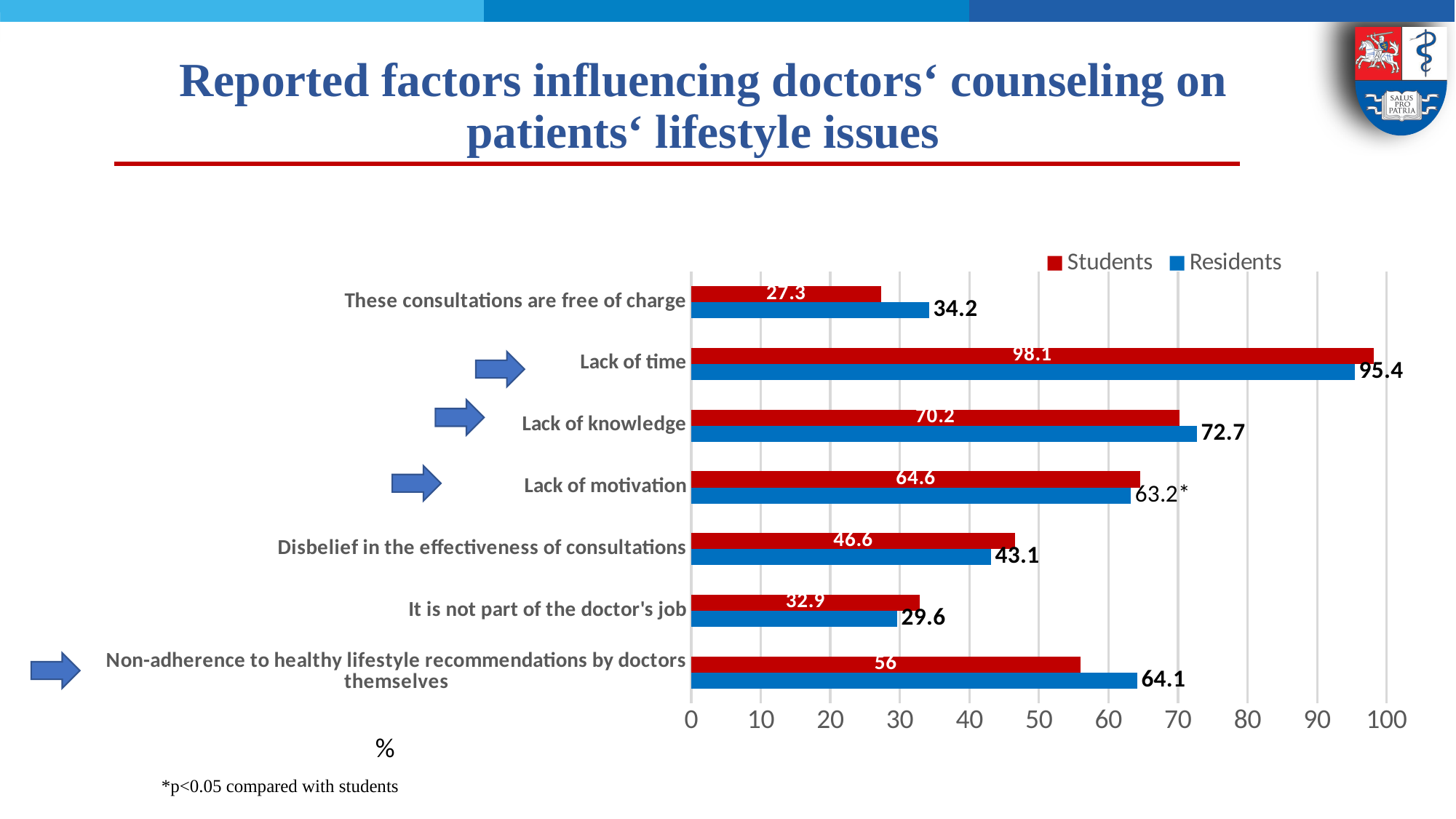
How many series does the legend list? 2 What is the Students value for "Lack of time"? 98.1 Which factor has the highest Students value? Lack of time Which factor has the lowest Residents value? It is not part of the doctor's job Is the Students value for "Disbelief in the effectiveness of consultations" greater or less than 50? less What is the difference between the Residents and Students values for "Non-adherence to healthy lifestyle recommendations by doctors themselves"? 8.1 For "Lack of knowledge", which group has the larger value, Students or Residents? Residents What kind of chart is shown on the slide? Bar chart What is the Residents value for "These consultations are free of charge"? 34.2 Which colour represents the Residents series? Blue What is the Residents value for "Non-adherence to healthy lifestyle recommendations by doctors themselves"? 64.1 How many factors (categories) are shown on the chart? 7